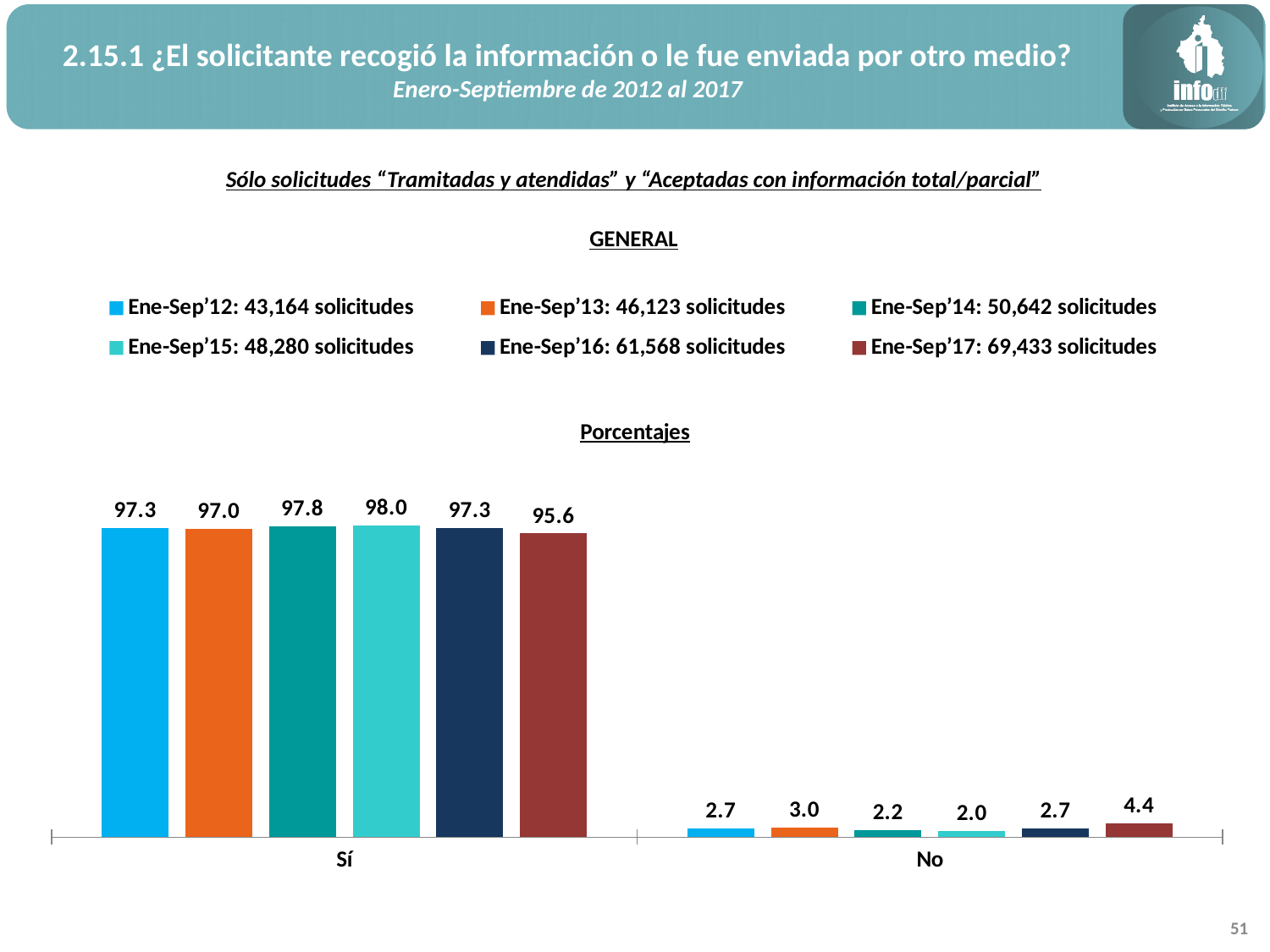
How many solicitudes does the legend give for Ene-Sep'16? 61,568 How many categories are shown on the x axis? 2 What is the value for Ene-Sep'15 in the Sí category? 98.0 What is the value for Ene-Sep'17 in the No category? 4.4 What is the difference between the Ene-Sep'15 and Ene-Sep'17 values in the Sí category? 2.4 Which series has the highest value in the Sí category? Ene-Sep'15 Which is larger in the Sí category: Ene-Sep'13 or Ene-Sep'14? Ene-Sep'14 How many series does the legend list? 6 What is the value for Ene-Sep'12 in the Sí category? 97.3 What kind of chart is shown on the slide? Bar chart Which series has the lowest value in the No category? Ene-Sep'15 What is the difference between the Ene-Sep'17 and Ene-Sep'15 values in the No category? 2.4